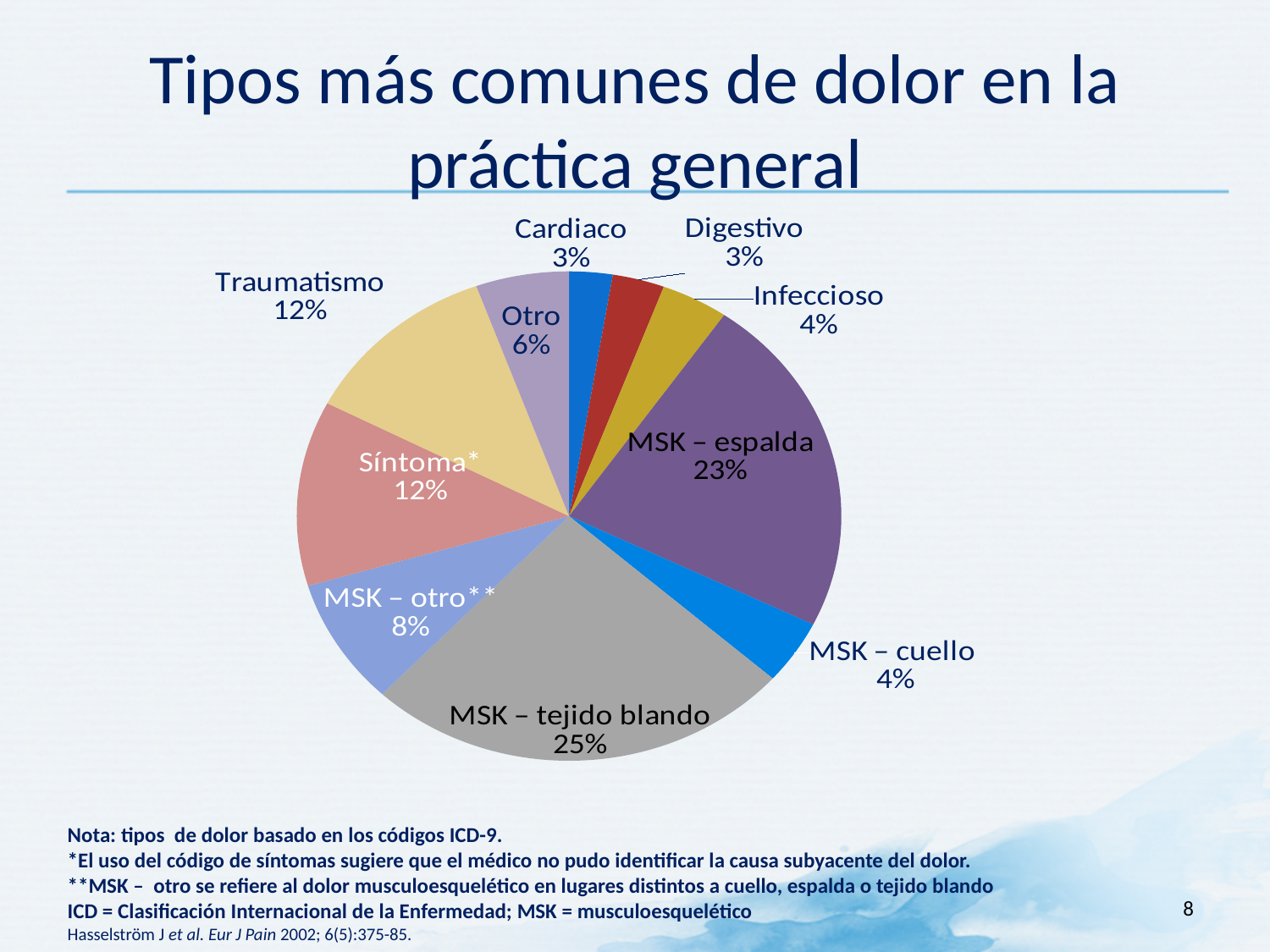
Which is larger, the Infeccioso slice or the Otro slice? Otro What is the value shown for MSK – espalda? 23% What is the value shown for Traumatismo? 12% Which category has the largest slice of the pie? MSK – tejido blando What is the combined share of Cardiaco and Digestivo? 6% What kind of chart is shown on the slide? pie chart What share of the pie does MSK – tejido blando represent? 25% What is the title of the chart on the slide? Tipos más comunes de dolor en la práctica general What is the value shown for Otro? 6% How many categories are shown in the pie chart? 10 What is the value shown for MSK – cuello? 4% What is the difference between the MSK – espalda and MSK – otro** slices? 15%